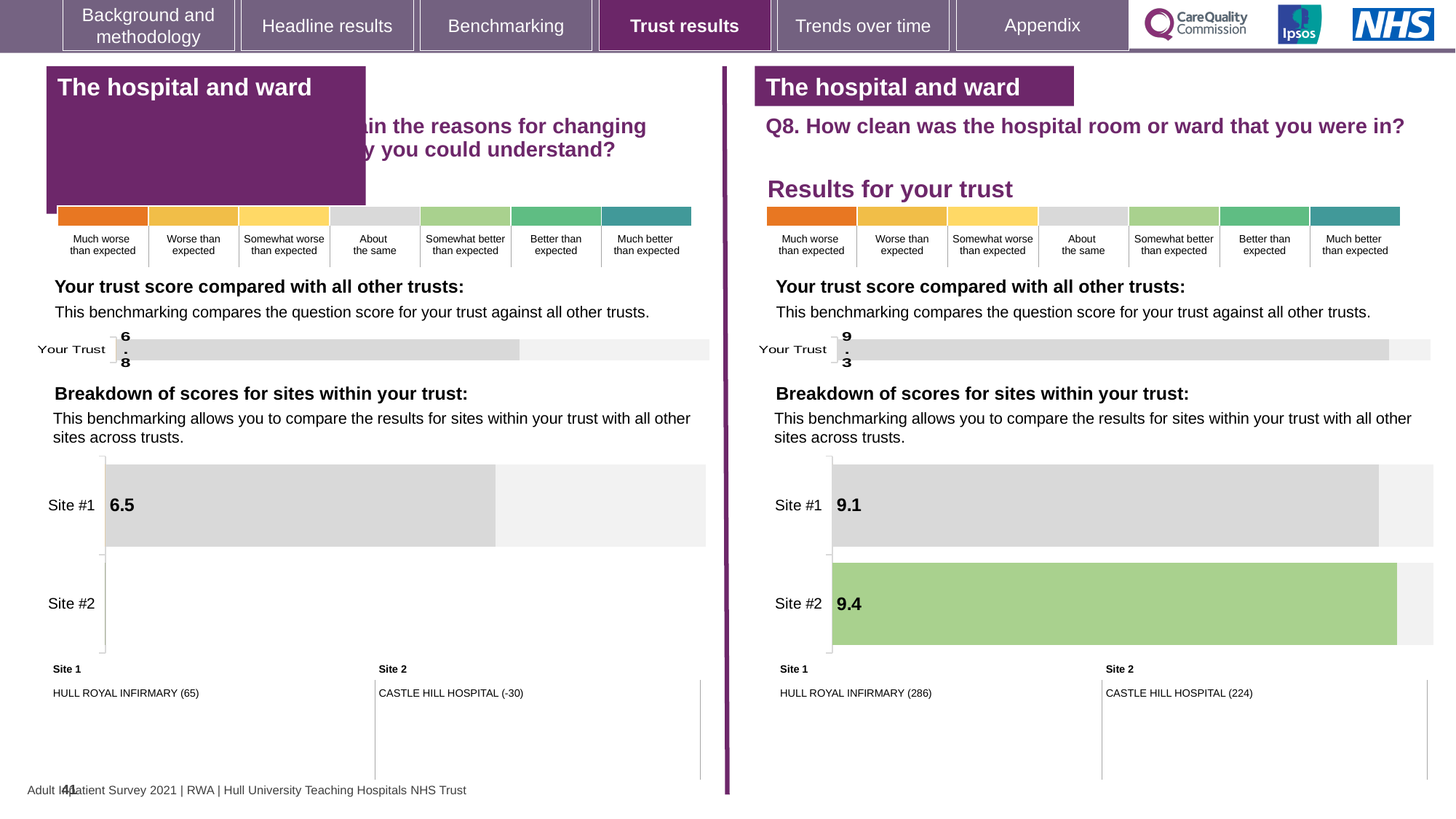
What kind of chart is used to show the breakdown of scores for sites on the right-hand side? Bar chart On the left-hand chart, what is the score for Site #1? 6.5 On the right-hand chart (Q8), what is the difference between the Site #2 score and the Site #1 score? 0.3 On the left-hand chart, what is the 'Your Trust' score? 6.8 On the right-hand chart (Q8), which site is named as Site 1? HULL ROYAL INFIRMARY On the right-hand chart (Q8), what is the score for Site #2? 9.4 On the left-hand chart, what is the difference between the 'Your Trust' score and the Site #1 score? 0.3 On the right-hand chart (Q8), what is the score for Site #1? 9.1 On the right-hand chart (Q8), how many sites are shown in the breakdown of scores? 2 On the right-hand chart (Q8), which site has the higher score, Site #1 or Site #2? Site #2 On the right-hand chart (Q8. How clean was the hospital room or ward that you were in?), what is the 'Your Trust' score? 9.3 On the right-hand chart (Q8), which site's bar is coloured green? Site #2